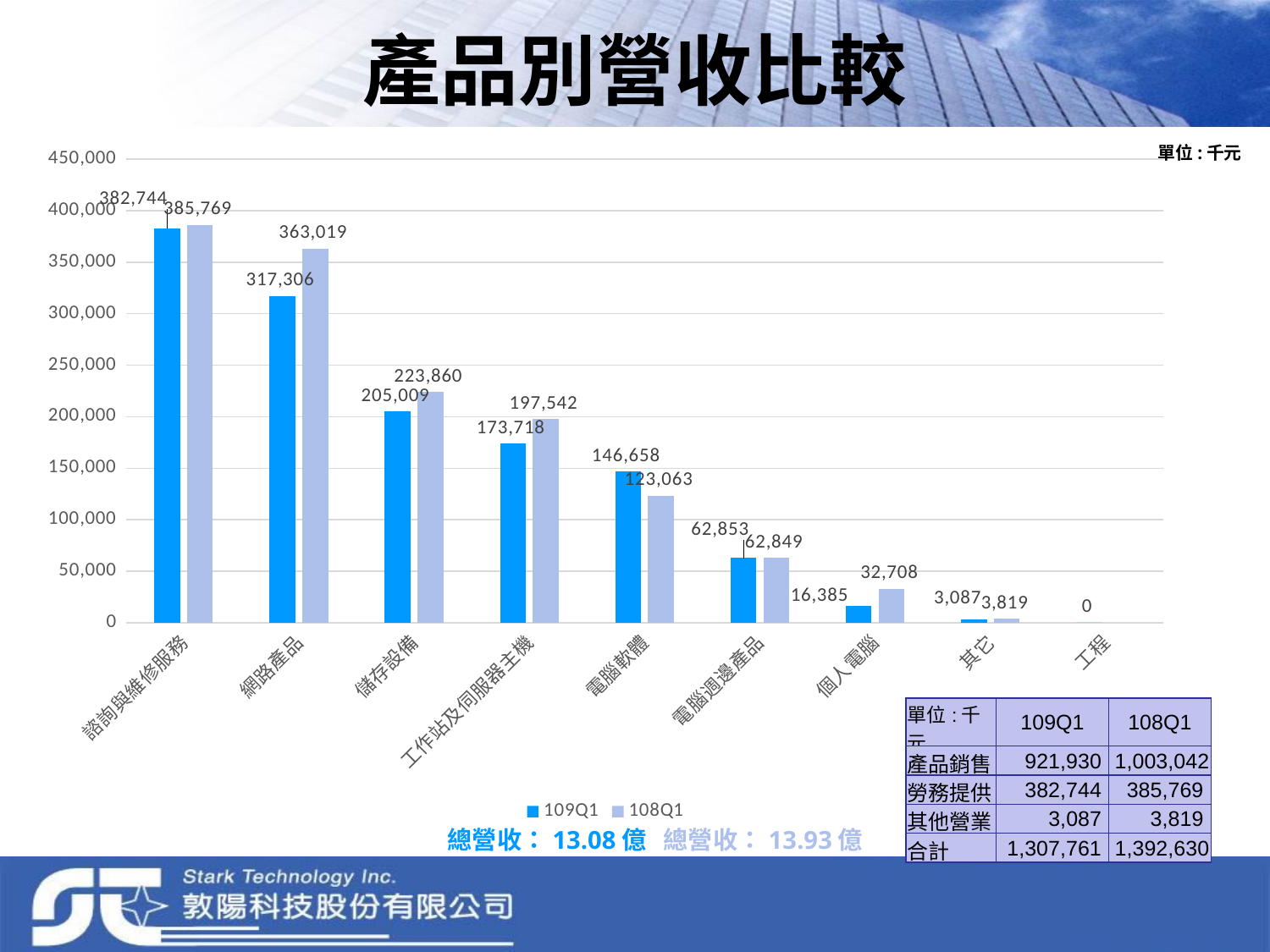
What kind of chart is shown on the slide? bar chart Is the 109Q1 value for 儲存設備 greater or less than 200,000? greater What is the 108Q1 value for 工作站及伺服器主機? 197,542 How many series does the legend list? 2 What is the 108Q1 value for 網路產品? 363,019 What is the difference between the 108Q1 and 109Q1 values for 網路產品? 45,713 Which category has the highest 109Q1 value? 諮詢與維修服務 How many product categories are shown on the x axis? 9 For 電腦軟體, which is larger: the 109Q1 value or the 108Q1 value? 109Q1 What is the 109Q1 value for 個人電腦? 16,385 What is the 109Q1 value for 諮詢與維修服務? 382,744 What is the difference between the 109Q1 and 108Q1 values for 電腦軟體? 23,595